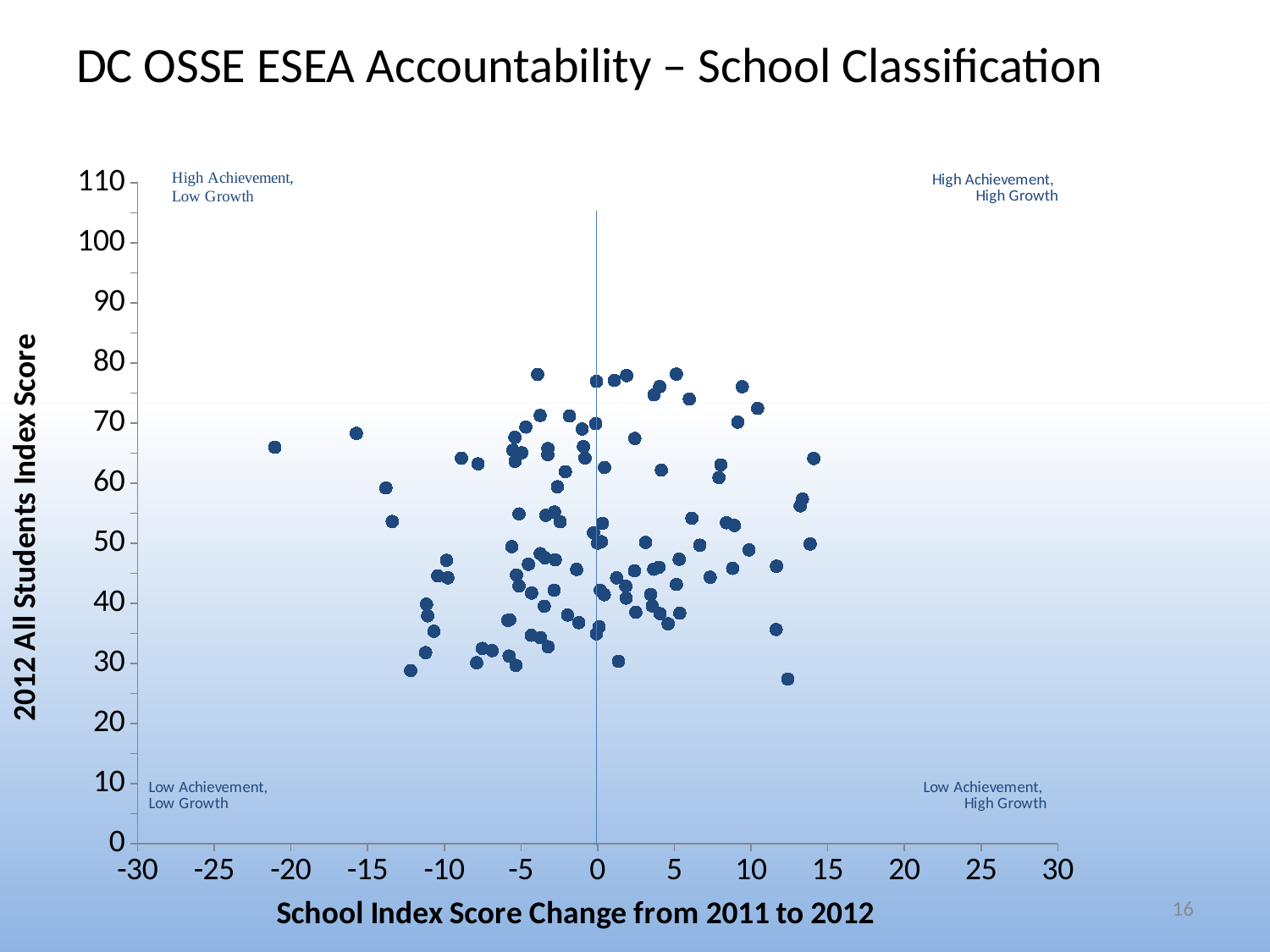
Are any points plotted to the left of -25 on the x axis? no What kind of chart is shown on the slide? scatter plot Is the lowest point on the chart greater or less than 30 on the y axis? less Are any points plotted below 20 on the y axis? no What is the title of the y axis of the chart? 2012 All Students Index Score What is the title of the x axis of the chart? School Index Score Change from 2011 to 2012